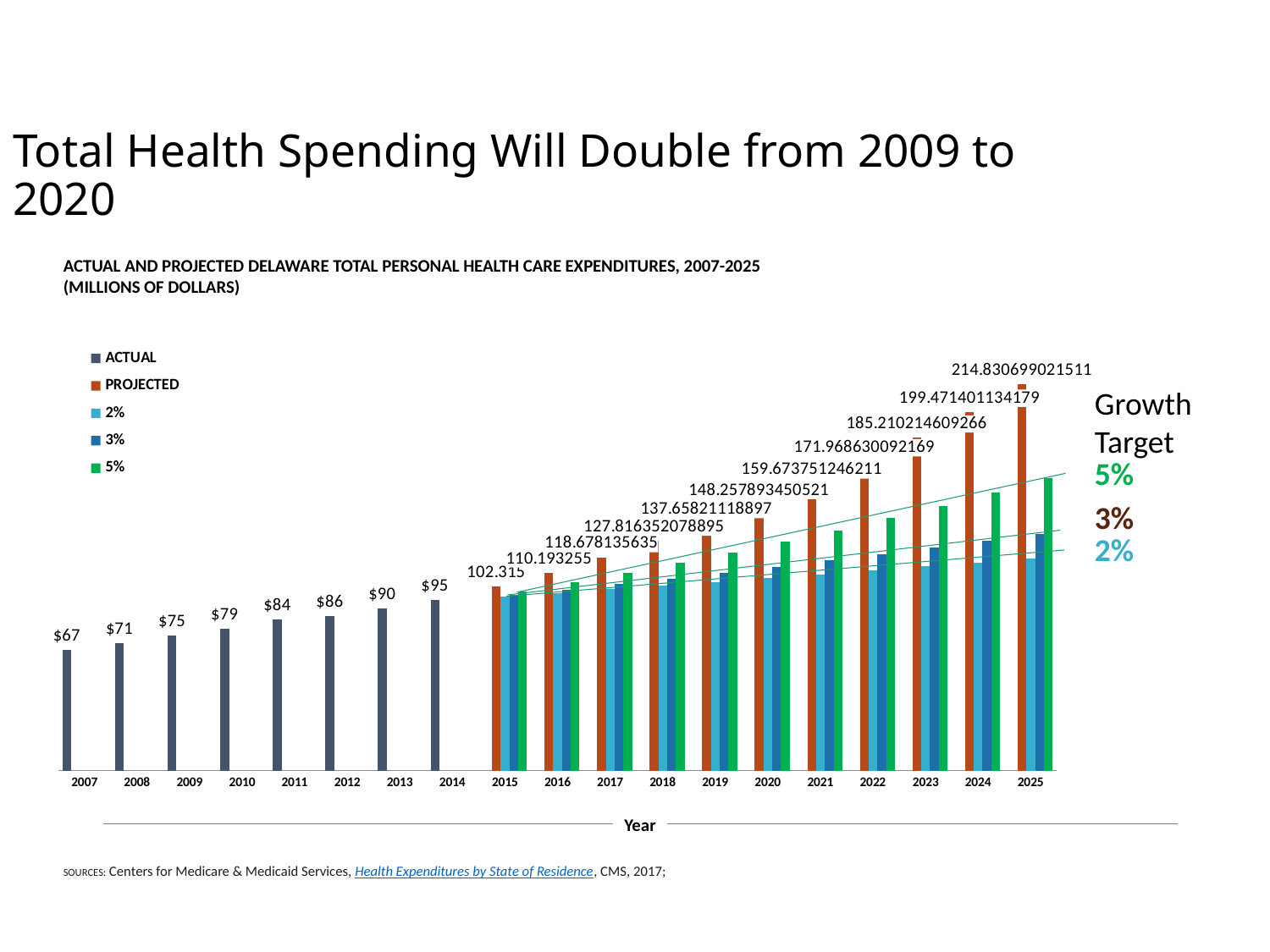
How many years are shown on the x axis? 19 Which year has the lowest ACTUAL value? 2007 Which year has the highest PROJECTED value? 2025 How many series does the legend list? 5 What kind of chart is shown on the slide? Bar chart What is the PROJECTED value for 2015? 102.315 What is the PROJECTED value for 2025? 214.830699021511 What is the ACTUAL value for 2007? $67 Which year has the larger ACTUAL value, 2011 or 2012? 2012 Do the PROJECTED values rise or fall from 2015 to 2025? Rise What is the difference between the ACTUAL values for 2014 and 2007? $28 What is the ACTUAL value for 2014? $95